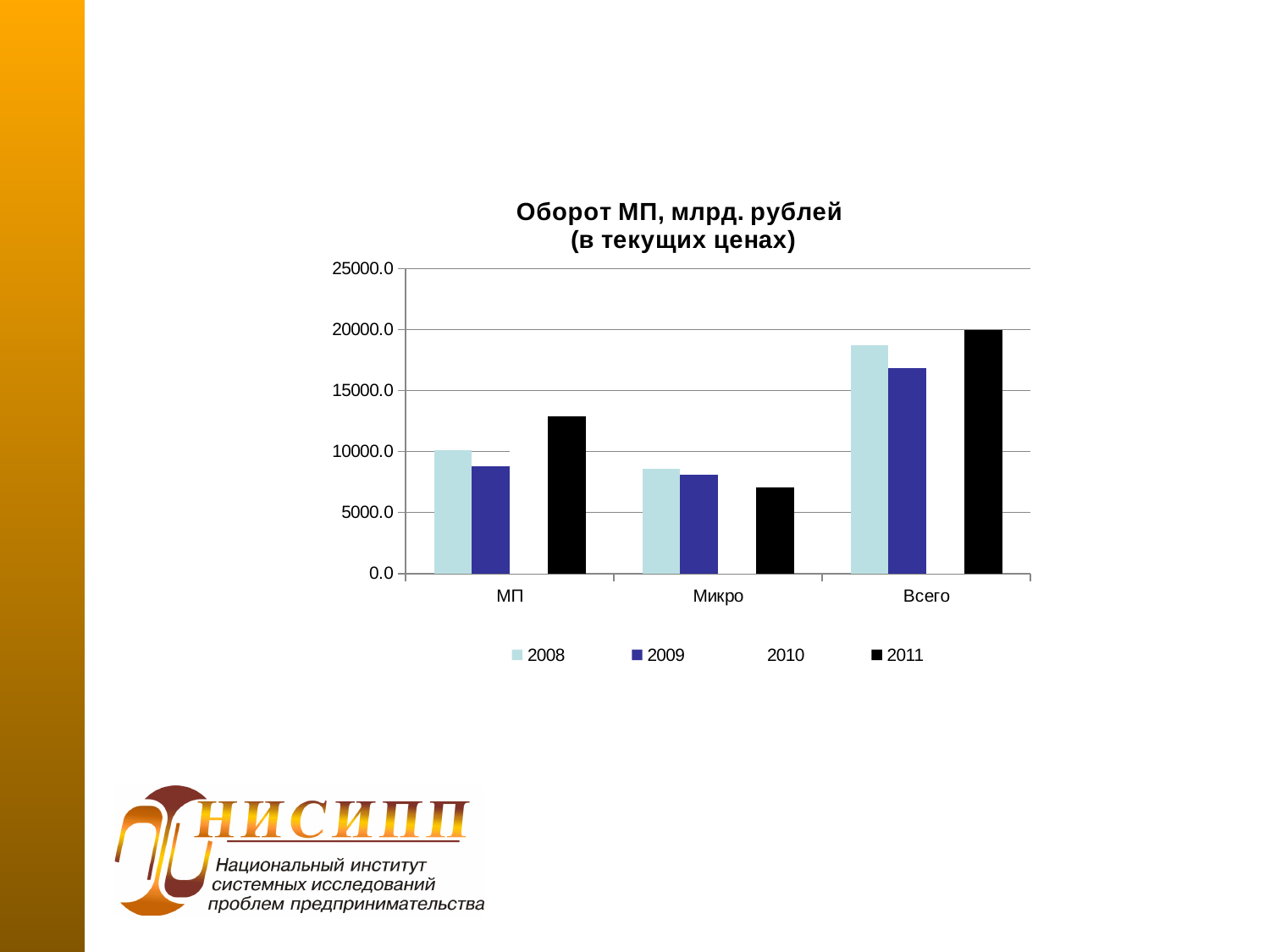
Is the 2009 value for МП greater or less than 10000.0? less What is the title of the chart? Оборот МП, млрд. рублей (в текущих ценах) For the category Микро, which is larger: the 2008 value or the 2011 value? 2008 What kind of chart is shown on the slide? bar chart How many categories are shown on the x axis of the chart? 3 Is the 2011 value for МП greater or less than 10000.0? greater Which years are listed in the chart's legend? 2008, 2009, 2010, 2011 Which category has the highest 2011 value? Всего Is the 2011 value for Микро greater or less than 5000.0? greater Which category has the lowest 2011 value? Микро How many series does the legend of the chart list? 4